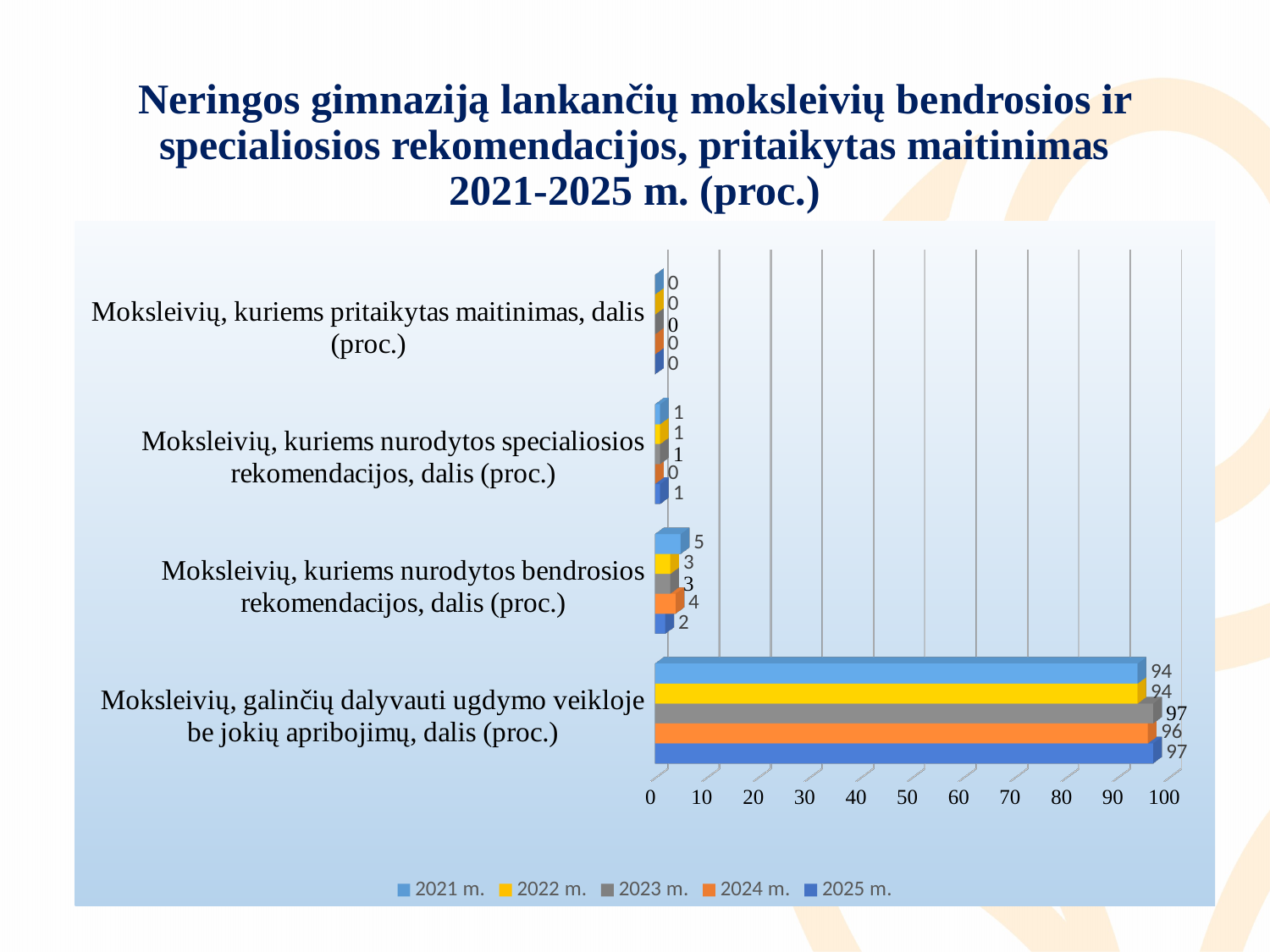
What is the value for 2021 m. in the category 'Mokslei­vių, galinčių dalyvauti ugdymo veikloje be jokių apribojimų, dalis (proc.)'? 94 What is the value for 2024 m. in the category 'Moksleivių, kuriems nurodytos specialiosios rekomendacijos, dalis (proc.)'? 0 What is the value for 2021 m. in the category 'Moksleivių, kuriems nurodytos bendrosios rekomendacijos, dalis (proc.)'? 5 Which year has the lowest value in the category 'Moksleivių, kuriems nurodytos bendrosios rekomendacijos, dalis (proc.)'? 2025 m. Which year has the highest value in the category 'Moksleivių, kuriems nurodytos bendrosios rekomendacijos, dalis (proc.)'? 2021 m. How many categories are plotted on the chart? 4 What is the value for 2025 m. in the category 'Moksleivių, galinčių dalyvauti ugdymo veikloje be jokių apribojimų, dalis (proc.)'? 97 What kind of chart is shown on the slide? bar chart What is the value for 2025 m. in the category 'Moksleivių, kuriems pritaikytas maitinimas, dalis (proc.)'? 0 How many series does the legend list? 5 In the category 'Moksleivių, galinčių dalyvauti ugdymo veikloje be jokių apribojimų, dalis (proc.)', which is larger: the value for 2024 m. or for 2022 m.? 2024 m. What is the difference between the 2023 m. and 2021 m. values in the category 'Moksleivių, galinčių dalyvauti ugdymo veikloje be jokių apribojimų, dalis (proc.)'? 3